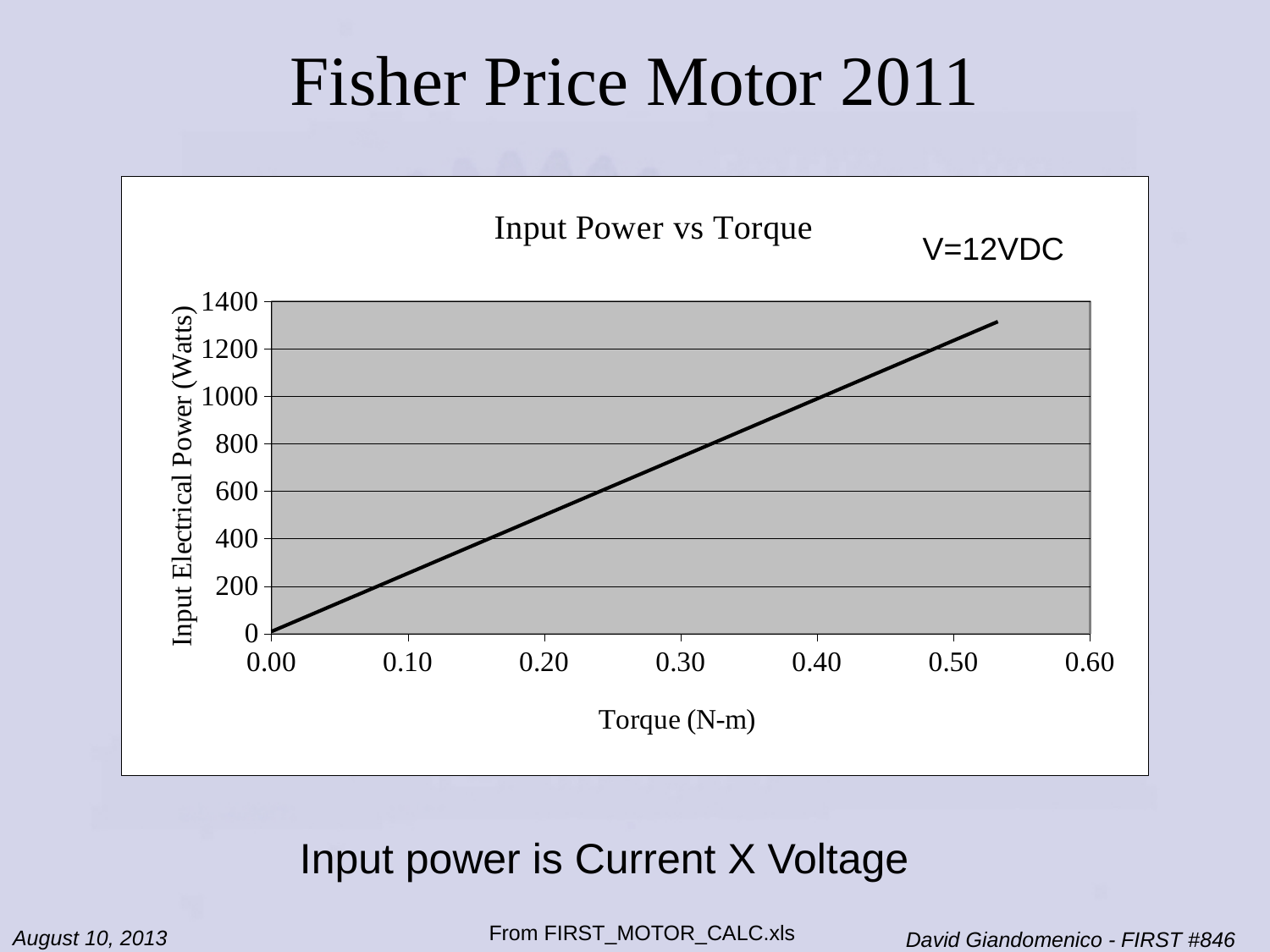
Which torque value has the higher input electrical power, 0.10 N-m or 0.40 N-m? 0.40 N-m What is the label of the y axis? Input Electrical Power (Watts) Is the input electrical power at a torque of 0.50 N-m greater or less than 1200 watts? greater Is the input electrical power at a torque of 0.10 N-m greater or less than 200 watts? greater Does input electrical power rise or fall as torque increases along the x axis? rise Is the input electrical power at a torque of 0.30 N-m greater or less than 600 watts? greater What kind of chart is shown on the slide? line chart What is the title of the chart? Input Power vs Torque